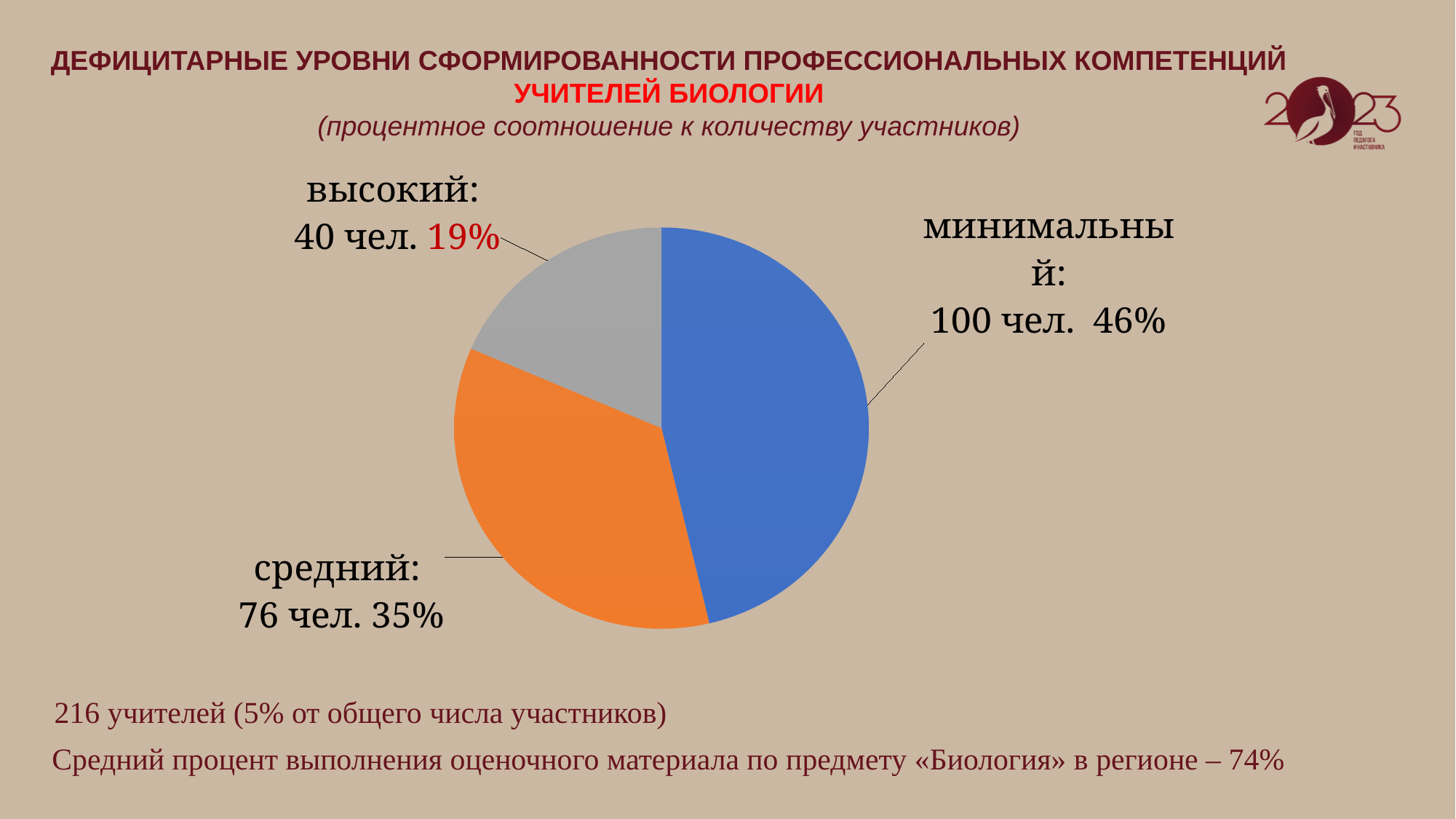
What is the difference in the number of people between the "минимальный" and "средний" levels? 24 чел. Which level has the smallest share of the pie? высокий How many slices does the pie chart have? 3 What colour is the slice for the "средний" level? orange What kind of chart is shown on the slide? pie chart Which level has the largest share of the pie? минимальный How many people (чел.) are in the "минимальный" level? 100 чел. Which is larger: the share for "средний" or the share for "высокий"? средний How many people (чел.) are in the "средний" level? 76 чел. What percentage is shown for the "минимальный" level? 46% What percentage is shown for the "высокий" level? 19% What is the difference in percentage points between the "минимальный" and "высокий" levels? 27